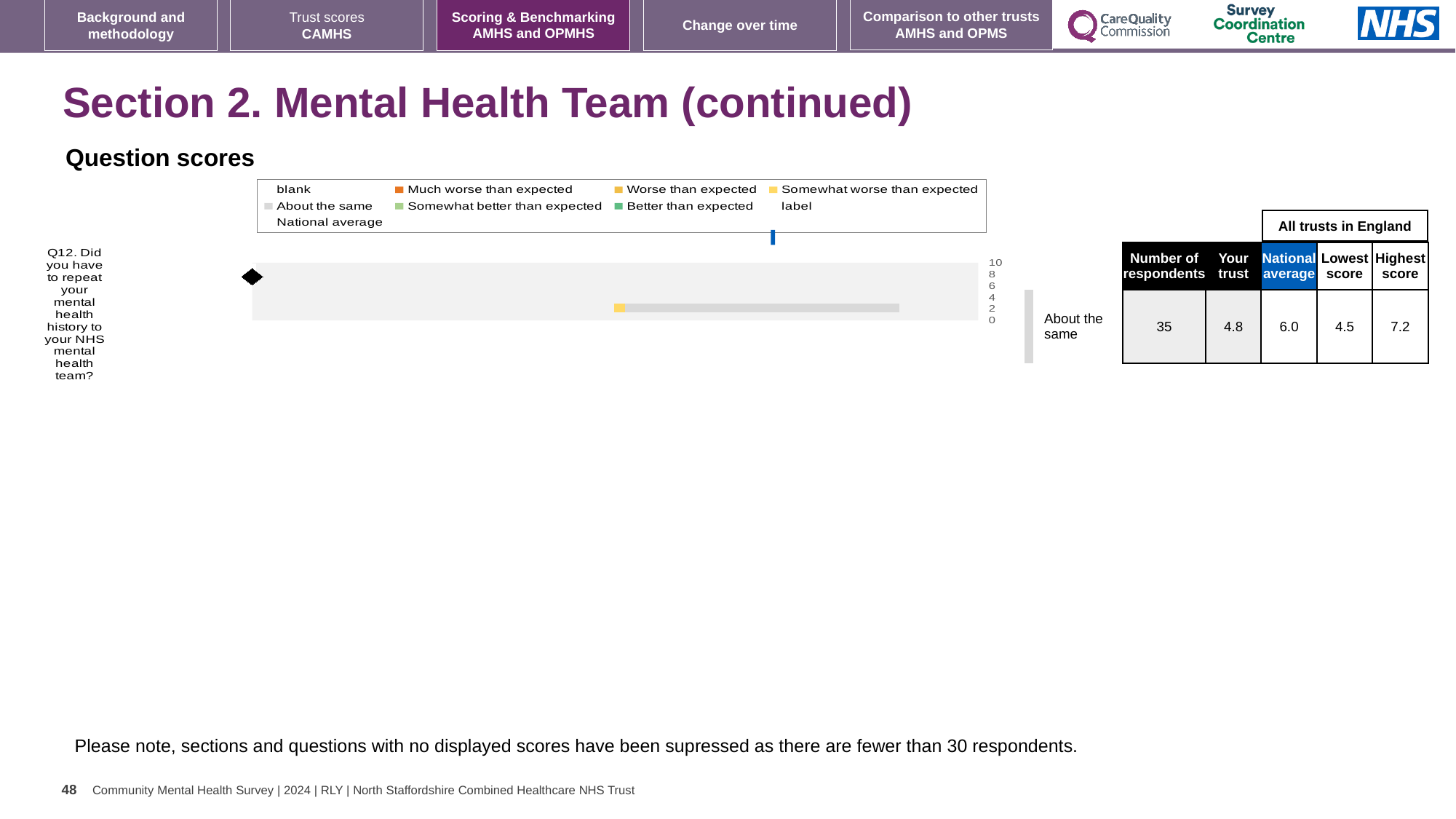
How many survey questions are plotted in the Question scores chart? 1 What is the 'Your trust' score for Q12 (repeating mental health history to the NHS mental health team)? 4.8 What is the difference between the highest and lowest trust scores in England for Q12? 2.7 What is the highest score among all trusts in England for Q12? 7.2 What is the lowest score among all trusts in England for Q12? 4.5 By how much does the national average exceed the trust's score for Q12? 1.2 What is the national average score for Q12? 6.0 What kind of chart is shown under 'Question scores'? bar chart What benchmark category is shown next to the Q12 bar? About the same For Q12, which is larger: the trust's score or the national average? National average Is the trust's score for Q12 greater or less than 6? less How many respondents answered Q12? 35